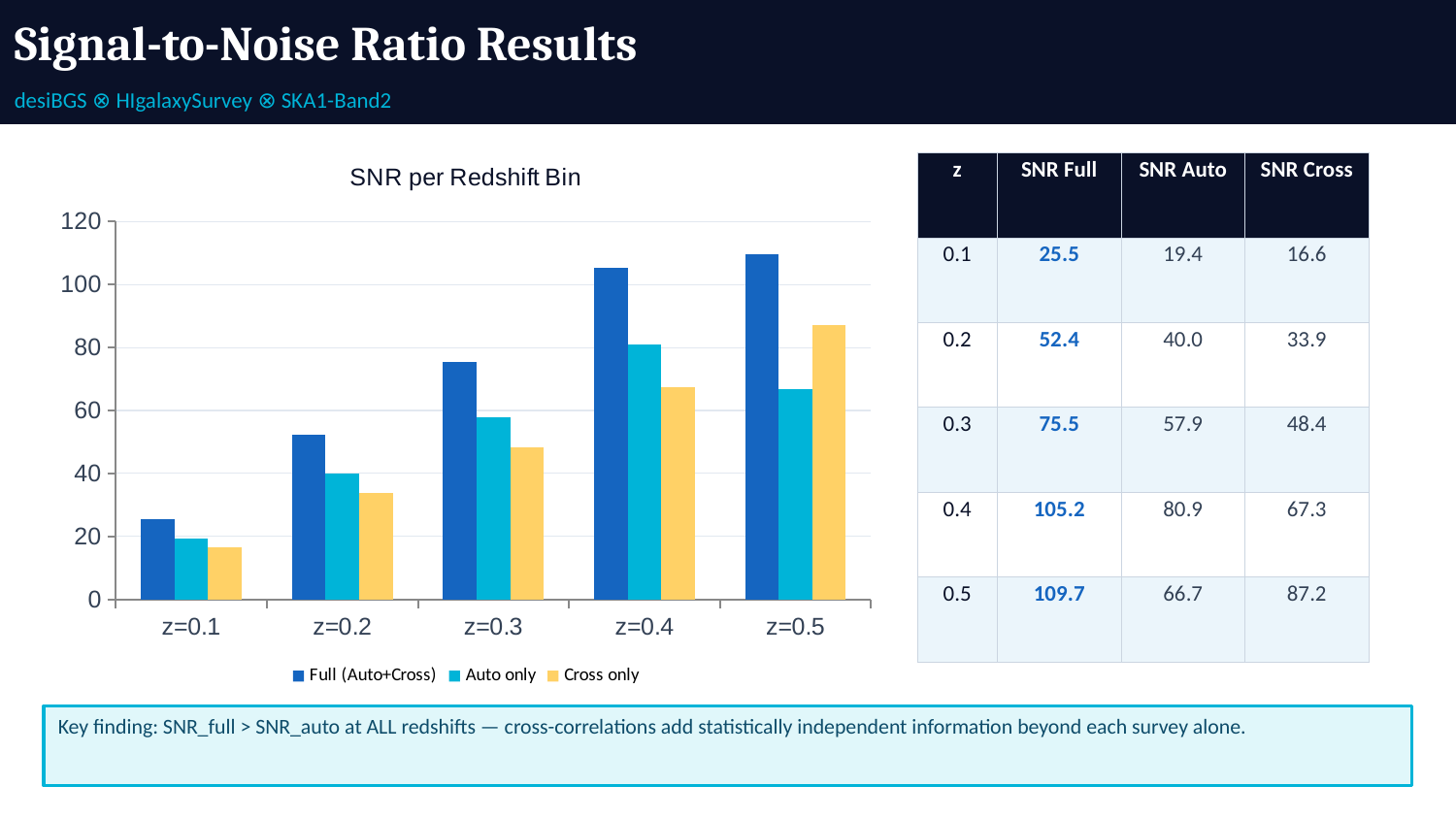
According to the slide, what is the difference between SNR Full and SNR Auto at z=0.5? 43.0 In the "SNR per Redshift Bin" chart, is the Cross only value at z=0.2 greater or less than 40? less Which redshift bin has the lowest Cross only value in the "SNR per Redshift Bin" chart? z=0.1 Which redshift bin has the highest Auto only value in the "SNR per Redshift Bin" chart? z=0.4 In the "SNR per Redshift Bin" chart, at z=0.5, which is larger: Auto only or Cross only? Cross only What kind of chart is "SNR per Redshift Bin"? bar chart In the "SNR per Redshift Bin" chart, is the Full (Auto+Cross) value at z=0.4 greater or less than 100? greater How many redshift bins are shown on the x axis of the "SNR per Redshift Bin" chart? 5 According to the slide, what is the SNR Full value at z=0.3? 75.5 How many series does the legend of the "SNR per Redshift Bin" chart list? 3 Do the Full (Auto+Cross) values rise or fall from z=0.1 to z=0.5 in the "SNR per Redshift Bin" chart? rise Which redshift bin has the highest Full (Auto+Cross) value in the "SNR per Redshift Bin" chart? z=0.5